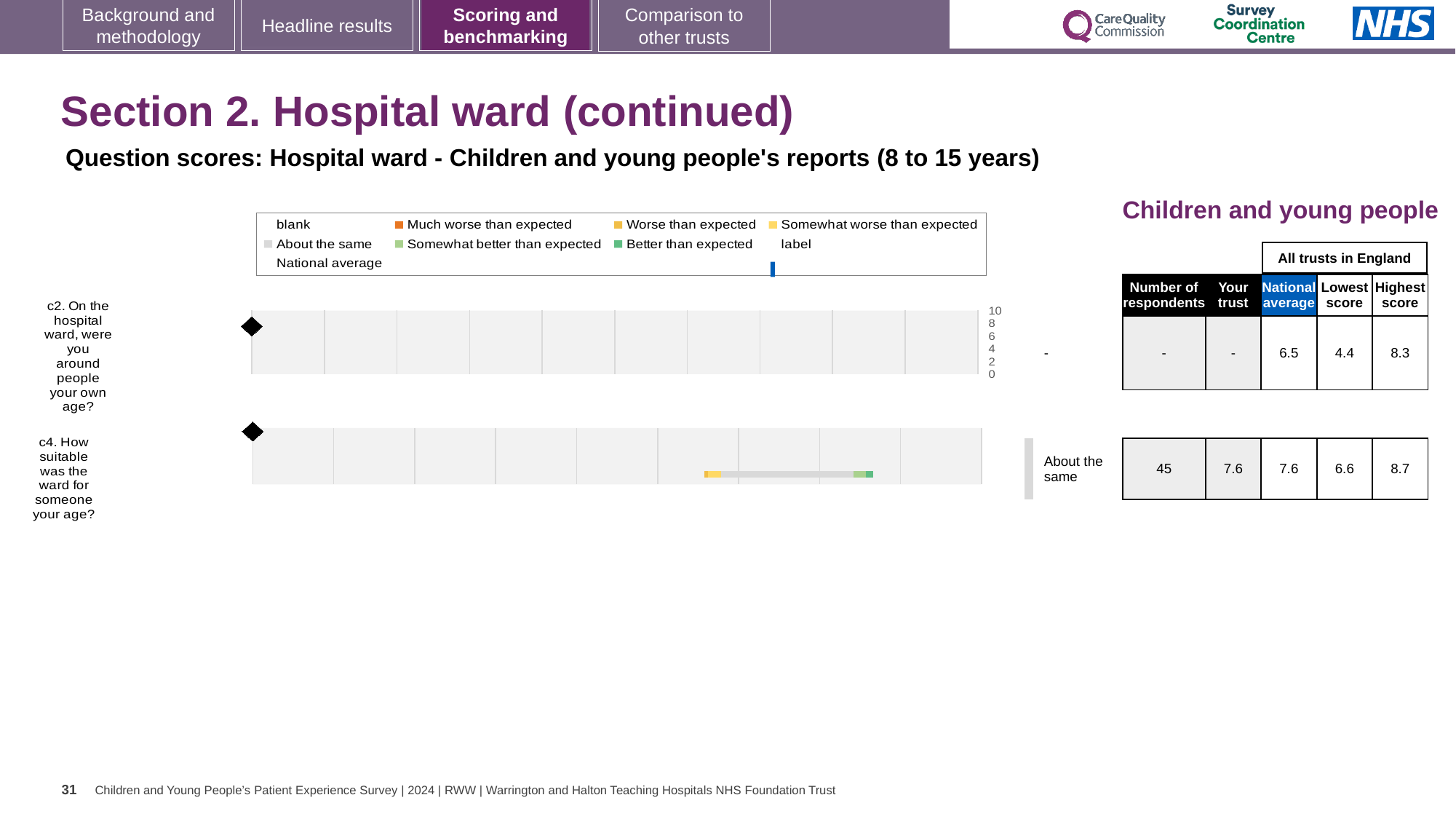
What is the 'Your trust' score for question c4 (How suitable was the ward for someone your age?)? 7.6 What is the difference between the highest score and the lowest score for question c4? 2.1 What benchmark category is shown for question c4? About the same How many respondents are recorded for question c4? 45 Which question has the higher 'Highest score' among all trusts in England, c2 or c4? c4 What is the national average score for question c2 (On the hospital ward, were you around people your own age?)? 6.5 What is the highest score among all trusts in England for question c4? 8.7 What is the lowest score among all trusts in England for question c2? 4.4 What kind of chart is used to show the question scores? Bar chart What is the difference between the highest score and the lowest score for question c2? 3.9 How many survey questions are plotted on the chart? 2 What is the national average score for question c4 (How suitable was the ward for someone your age?)? 7.6